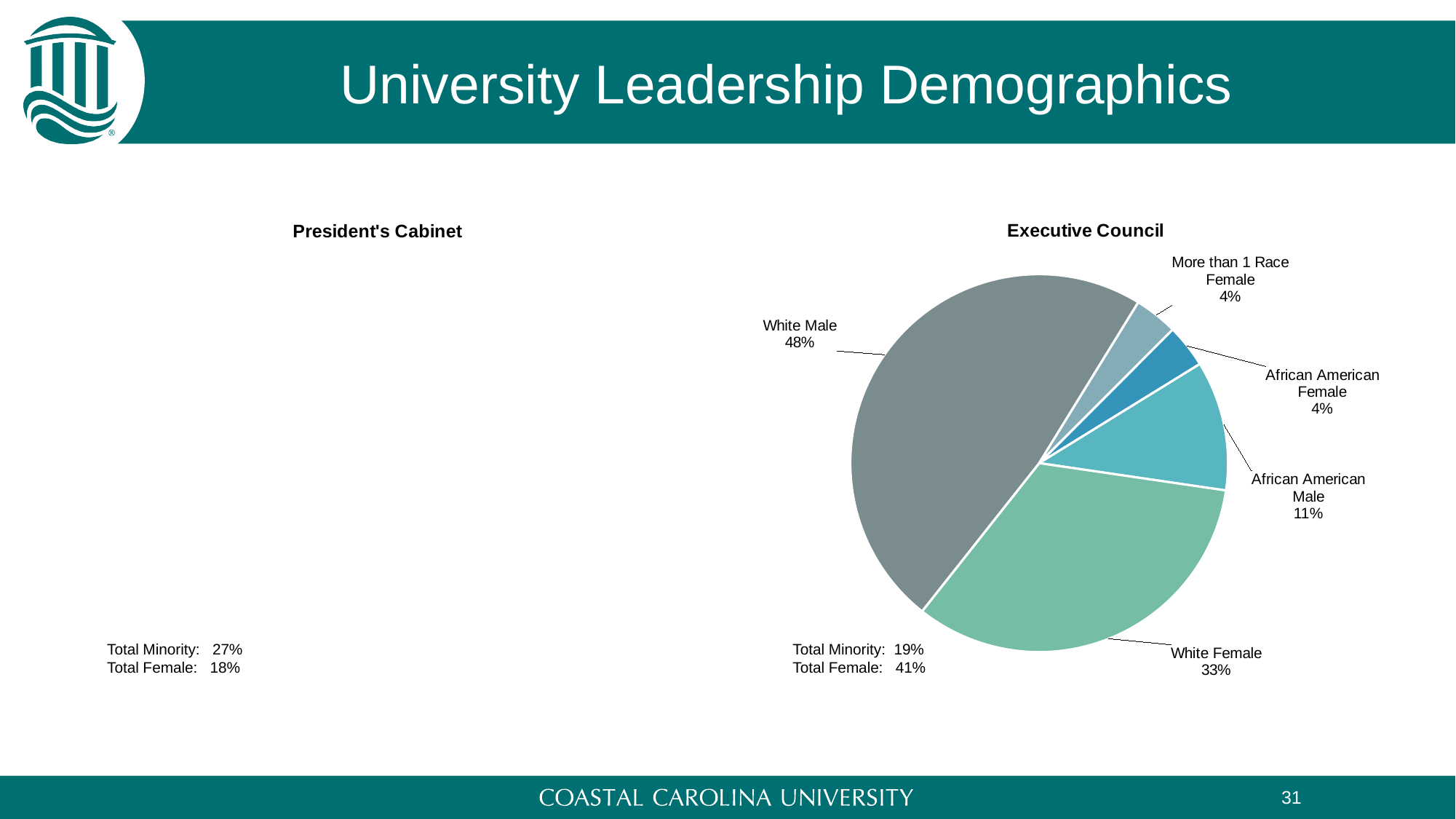
In the Executive Council chart, which category has the largest slice? White Male In the Executive Council chart, what percentage is African American Female? 4% How many slices does the Executive Council pie chart have? 5 In the Executive Council chart, what is the difference between the White Male and White Female percentages? 15% In the Executive Council chart, what percentage is African American Male? 11% In the Executive Council chart, what percentage is White Male? 48% In the Executive Council chart, what percentage is White Female? 33% In the Executive Council chart, which is larger, White Female or African American Male? White Female What type of chart is the Executive Council chart? Pie chart In the Executive Council chart, what percentage is More than 1 Race Female? 4% In the Executive Council chart, what is the difference between the African American Male and African American Female percentages? 7% What is the title of the chart on the right side of the slide? Executive Council